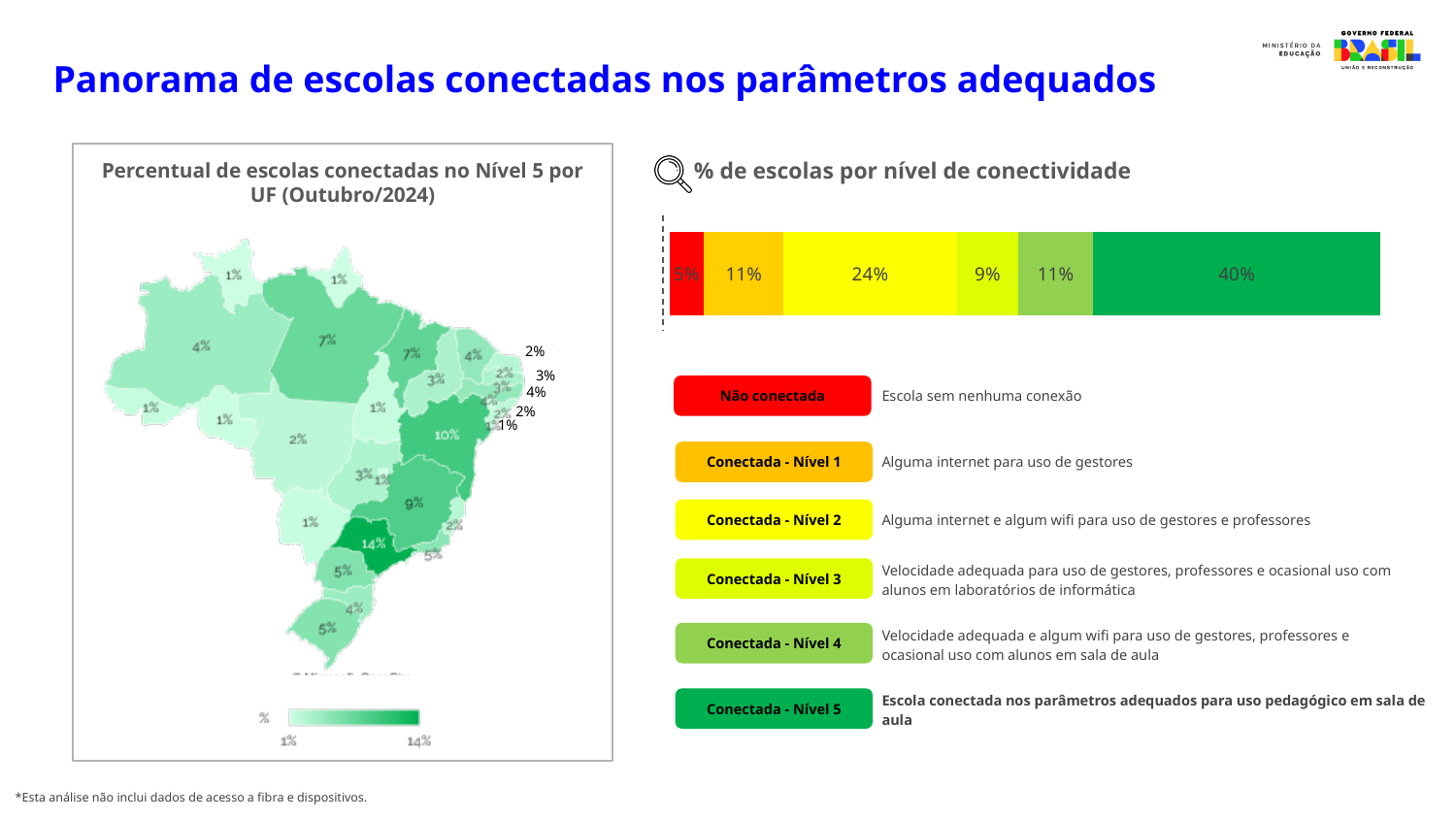
In the '% de escolas por nível de conectividade' bar, which connectivity level has the smallest share of schools? Não conectada What is the title of the map chart on the left of the slide? Percentual de escolas conectadas no Nível 5 por UF (Outubro/2024) What is the total of all segments in the '% de escolas por nível de conectividade' bar? 100% In the '% de escolas por nível de conectividade' bar, which connectivity level has the largest share of schools? Conectada - Nível 5 In the '% de escolas por nível de conectividade' bar, what percentage of schools are 'Conectada - Nível 2'? 24% In the '% de escolas por nível de conectividade' bar, which is larger: the share for 'Conectada - Nível 2' or for 'Conectada - Nível 3'? Conectada - Nível 2 In the '% de escolas por nível de conectividade' bar, what is the difference in percentage points between 'Conectada - Nível 5' and 'Conectada - Nível 2'? 16 What kind of chart is the '% de escolas por nível de conectividade' visual? Stacked bar chart In the '% de escolas por nível de conectividade' bar, what percentage of schools are 'Conectada - Nível 5'? 40% In the '% de escolas por nível de conectividade' bar, what percentage of schools are 'Não conectada'? 5% In the '% de escolas por nível de conectividade' bar, what percentage of schools are 'Conectada - Nível 3'? 9% How many segments (connectivity levels) does the '% de escolas por nível de conectividade' bar contain? 6